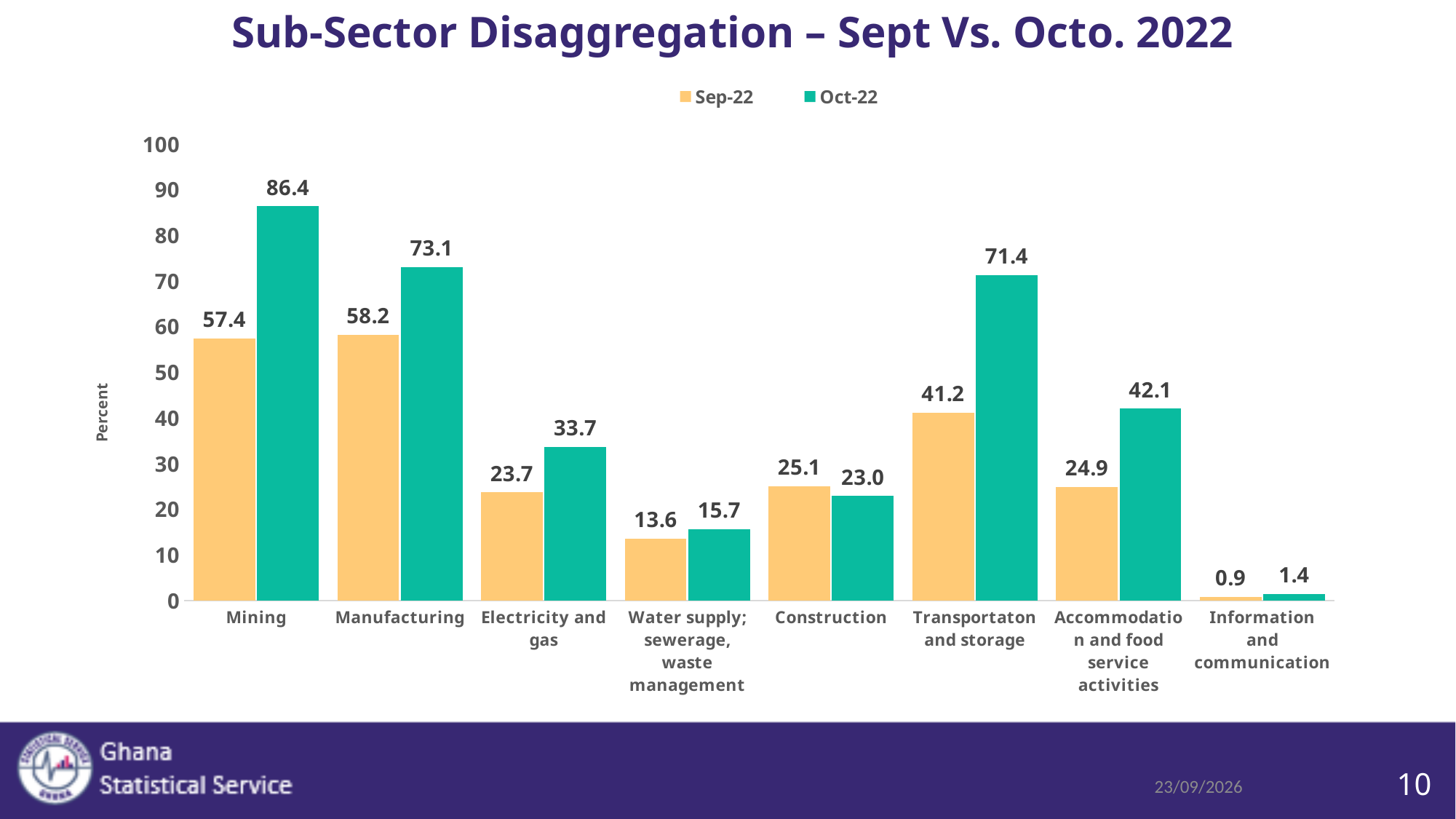
What is the Oct-22 value for Construction? 23.0 Which category has the lowest Sep-22 value? Information and communication What is the Sep-22 value for Transportaton and storage? 41.2 Which is larger for Construction, the Sep-22 value or the Oct-22 value? Sep-22 Which category has the highest Oct-22 value? Mining Is the Oct-22 value for Manufacturing greater or less than 70? greater How many series does the legend list? 2 What kind of chart is shown on the slide? bar chart What is the difference between the Oct-22 and Sep-22 values for Mining? 29.0 What is the Oct-22 value for Mining? 86.4 What is the label of the vertical axis? Percent How many categories are shown on the x axis? 8